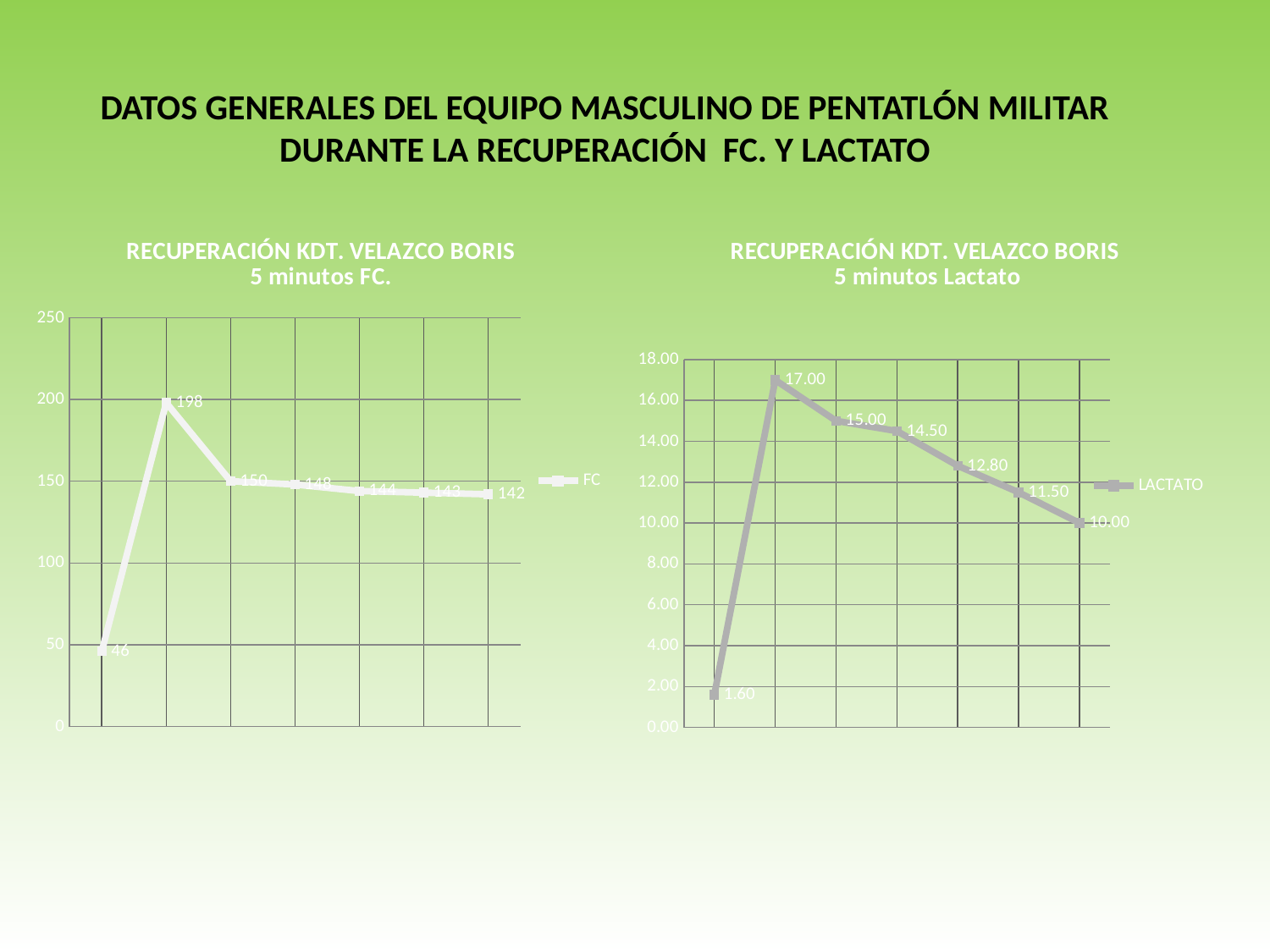
In the right chart (5 minutos Lactato), do the values rise or fall from the second data point to the last data point? Fall In the left chart (5 minutos FC.), what is the value of the first data point? 46 What type of chart is the right chart (5 minutos Lactato)? Line chart What series name does the legend of the right chart show? LACTATO In the right chart (5 minutos Lactato), what is the lowest value plotted? 1.60 In the right chart (5 minutos Lactato), what is the value of the last data point? 10.00 In the left chart (5 minutos FC.), what is the value of the last data point? 142 How many data points are plotted in the left chart (5 minutos FC.)? 7 In the right chart (5 minutos Lactato), what is the value of the second data point? 17.00 In the right chart (5 minutos Lactato), what is the difference between the third data point (15.00) and the fourth data point (14.50)? 0.50 In the left chart (5 minutos FC.), what is the difference between the second data point (198) and the third data point (150)? 48 In the left chart (5 minutos FC.), what is the highest value plotted? 198